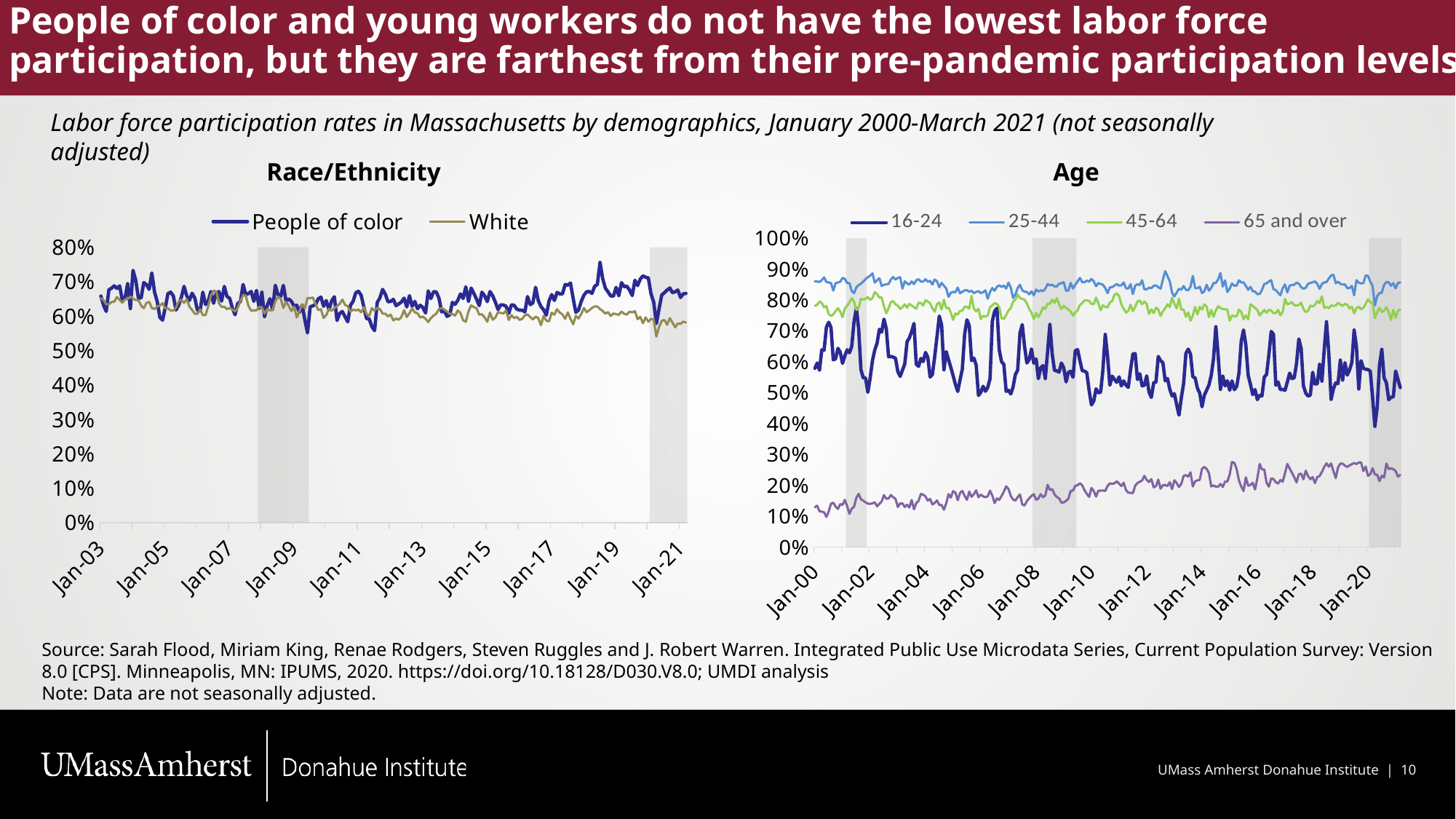
In the Race/Ethnicity chart, which series is higher around Jan-19, People of color or White? People of color In the Race/Ethnicity chart, is the participation rate for White greater or less than 70% across the whole period? less In the Age chart, which age group has the lowest labor force participation rate throughout the period? 65 and over How many series does the legend of the Age chart list? 4 What are the two series listed in the legend of the Race/Ethnicity chart? People of color and White In the Age chart, does the participation rate for the 65 and over group rise or fall from Jan-00 to Jan-20? rise In the Age chart, which age group has the highest labor force participation rate throughout the period? 25-44 In the Age chart, which series is higher, 25-44 or 45-64? 25-44 What kind of chart is the Race/Ethnicity chart? line chart How many series does the legend of the Race/Ethnicity chart list? 2 In the Age chart, is the participation rate for the 65 and over group greater or less than 30% across the whole period? less